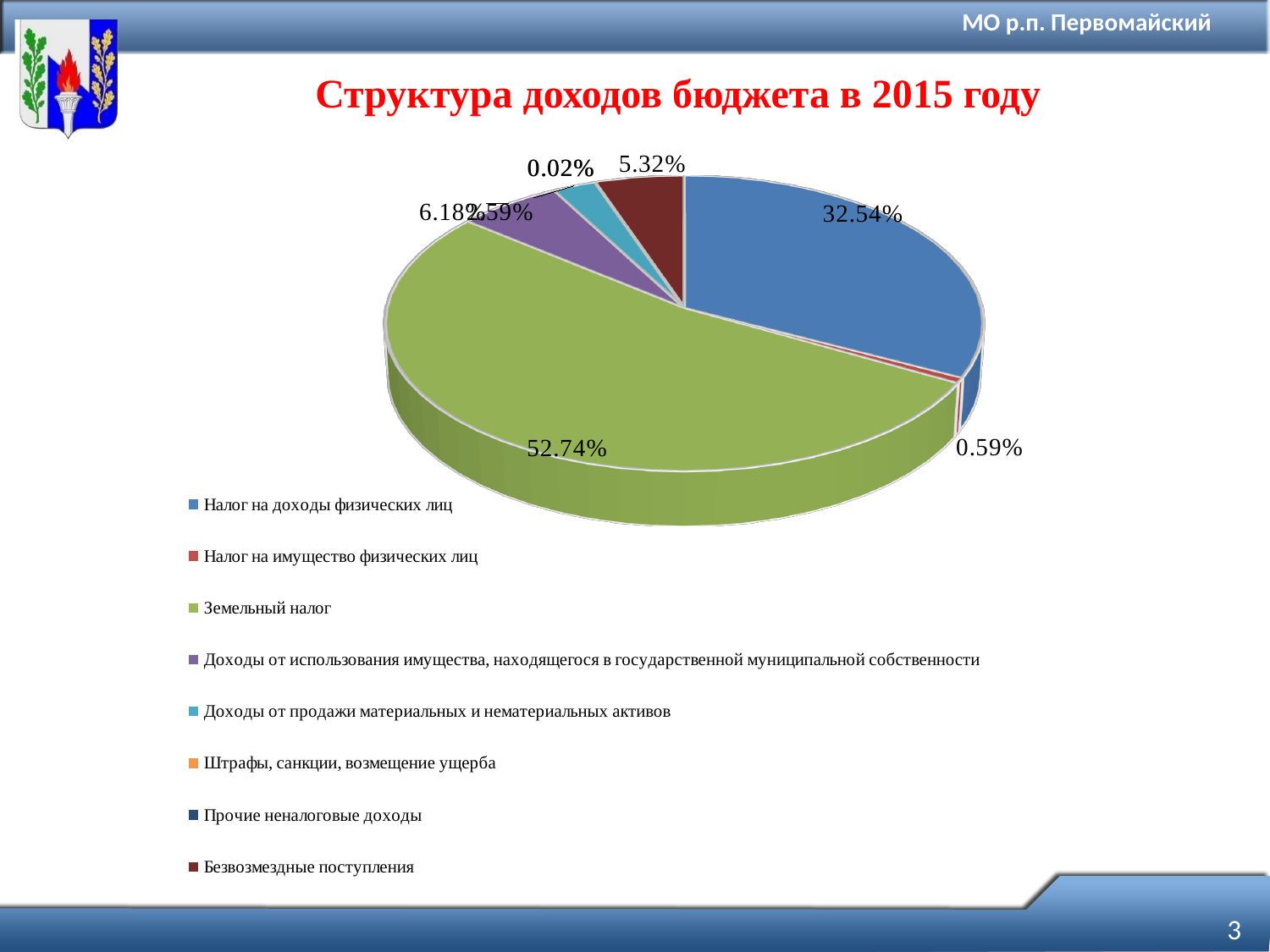
What share of the pie is Земельный налог? 52.74% What is the value shown for Доходы от использования имущества, находящегося в государственной муниципальной собственности? 6.18% What is the value shown for Доходы от продажи материальных и нематериальных активов? 2.59% Which category has the largest share of the pie? Земельный налог What is the difference between the shares of Земельный налог and Налог на доходы физических лиц? 20.20% What share of the pie is Налог на доходы физических лиц? 32.54% How many entries does the chart legend list? 8 What kind of chart is shown on the slide? pie chart What is the value shown for Безвозмездные поступления? 5.32% What is the value shown for Налог на имущество физических лиц? 0.59% What is the title of the chart? Структура доходов бюджета в 2015 году Which is larger: the share of Безвозмездные поступления or the share of Доходы от продажи материальных и нематериальных активов? Безвозмездные поступления